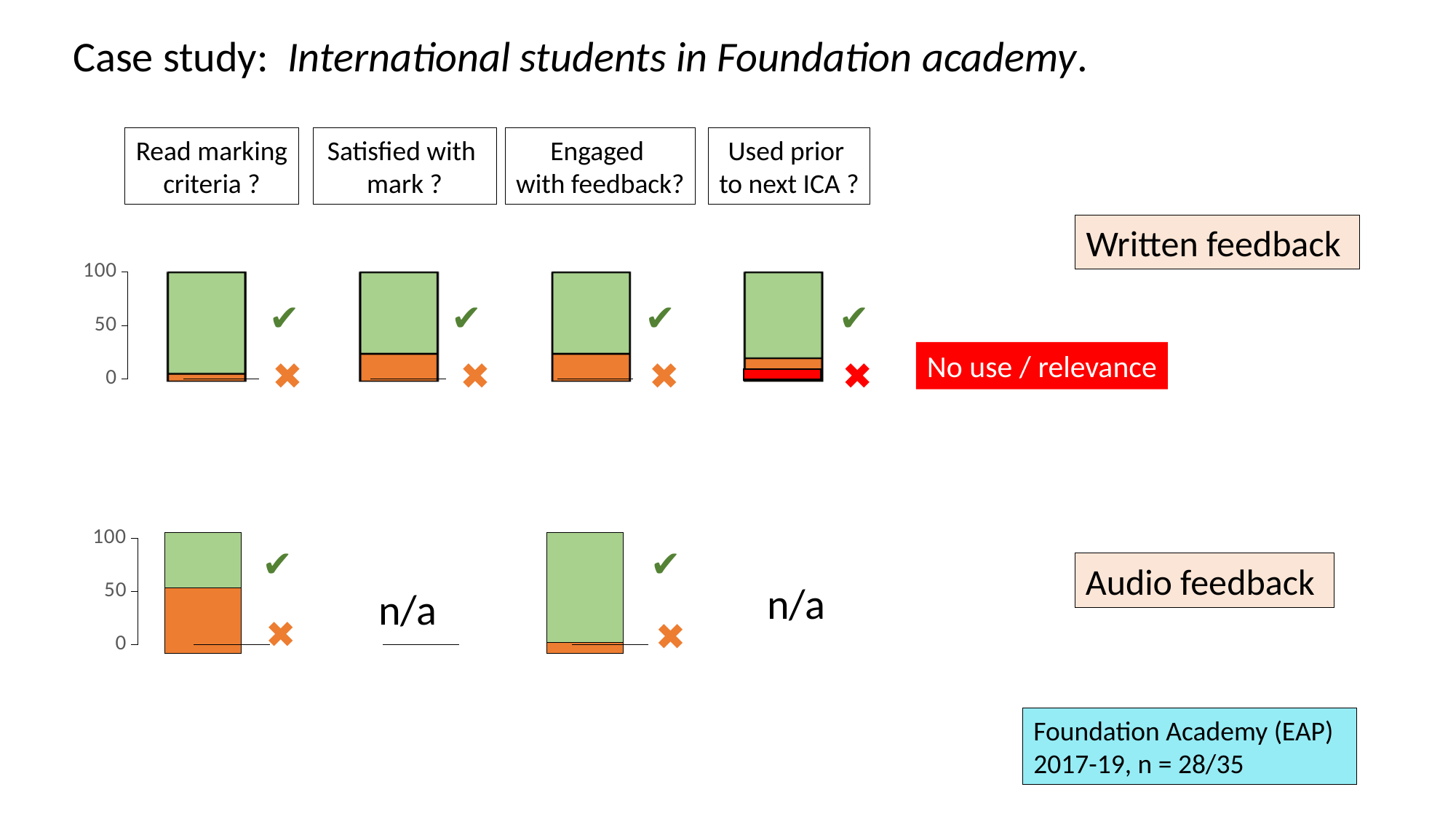
How many bars are shown in the Written feedback chart? 4 In the Audio feedback chart, is the orange (cross) portion of the 'Engaged with feedback?' bar greater or less than 50? less In the Written feedback chart, which question has the largest orange (cross) portion: 'Read marking criteria ?' or 'Satisfied with mark ?'? Satisfied with mark ? In the Written feedback chart, is the orange (cross) portion of the 'Satisfied with mark ?' bar greater or less than 50? less In the Written feedback chart, is the orange portion of the 'Engaged with feedback?' bar greater or less than 50? less In the Audio feedback chart, which bar has the larger orange (cross) portion: 'Read marking criteria ?' or 'Engaged with feedback?'? Read marking criteria ? In the Written feedback chart, which bar contains a red segment labelled 'No use / relevance'? Used prior to next ICA ? How many bars are shown in the Audio feedback chart? 2 What kind of chart is used on the slide to show the Written feedback results? Stacked bar chart Which questions in the Audio feedback chart are marked 'n/a'? Satisfied with mark ? and Used prior to next ICA ? What is the highest value shown on the vertical axis of the charts? 100